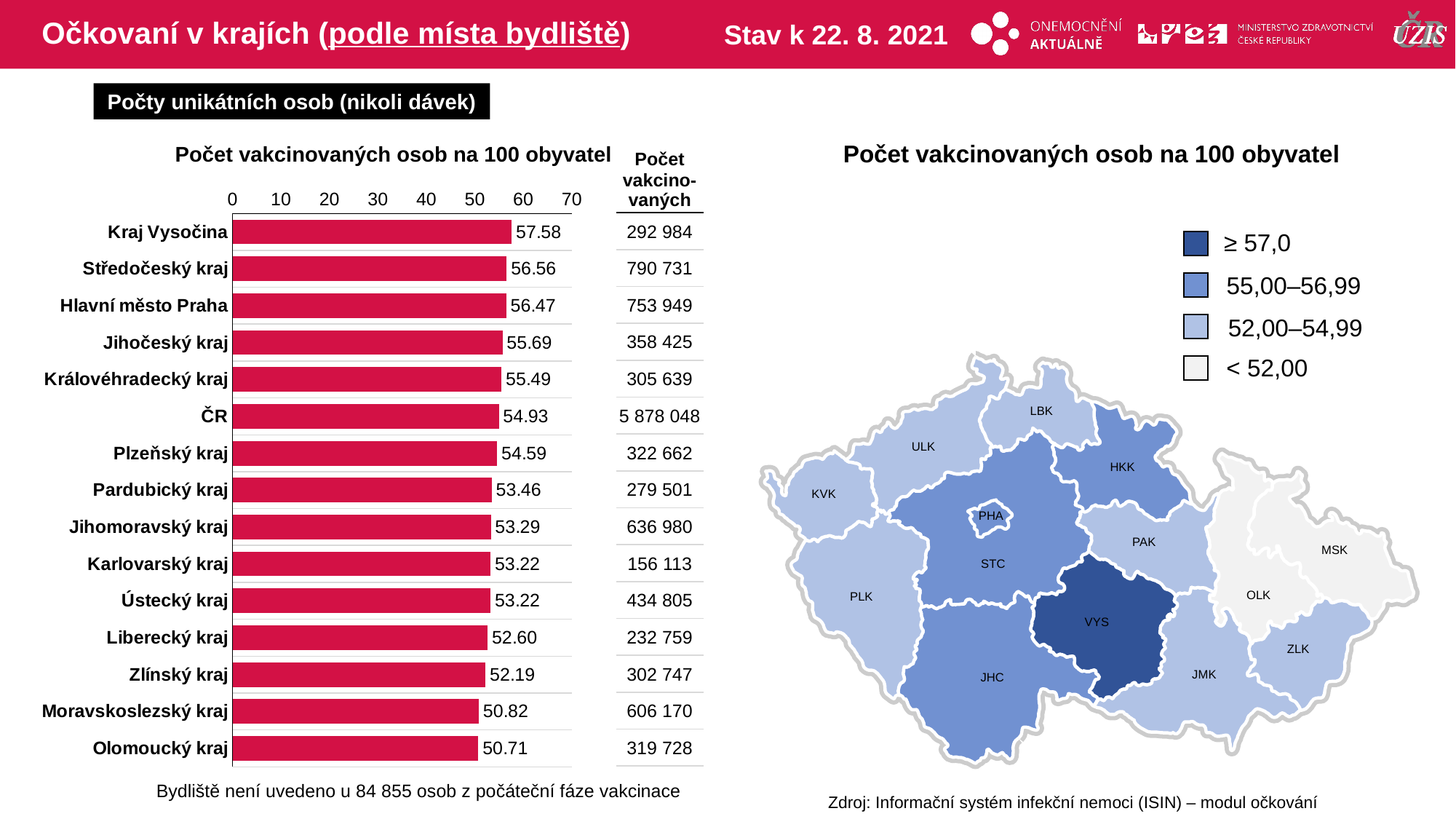
Which category has the highest value in the bar chart? Kraj Vysočina What is the difference between the values for Kraj Vysočina and Olomoucký kraj in the bar chart? 6.87 What colour are the bars in the bar chart? red In the bar chart, what is the value for Kraj Vysočina? 57.58 In the bar chart, which has a larger value, Jihočeský kraj or Liberecký kraj? Jihočeský kraj What is the difference between the values for Středočeský kraj and Hlavní město Praha in the bar chart? 0.09 How many categories are shown in the bar chart? 15 Which category has the lowest value in the bar chart? Olomoucký kraj What is the title of the bar chart on the left? Počet vakcinovaných osob na 100 obyvatel In the bar chart, what is the value for ČR? 54.93 In the bar chart, what is the value for Plzeňský kraj? 54.59 What type of chart is shown on the left of the slide? bar chart